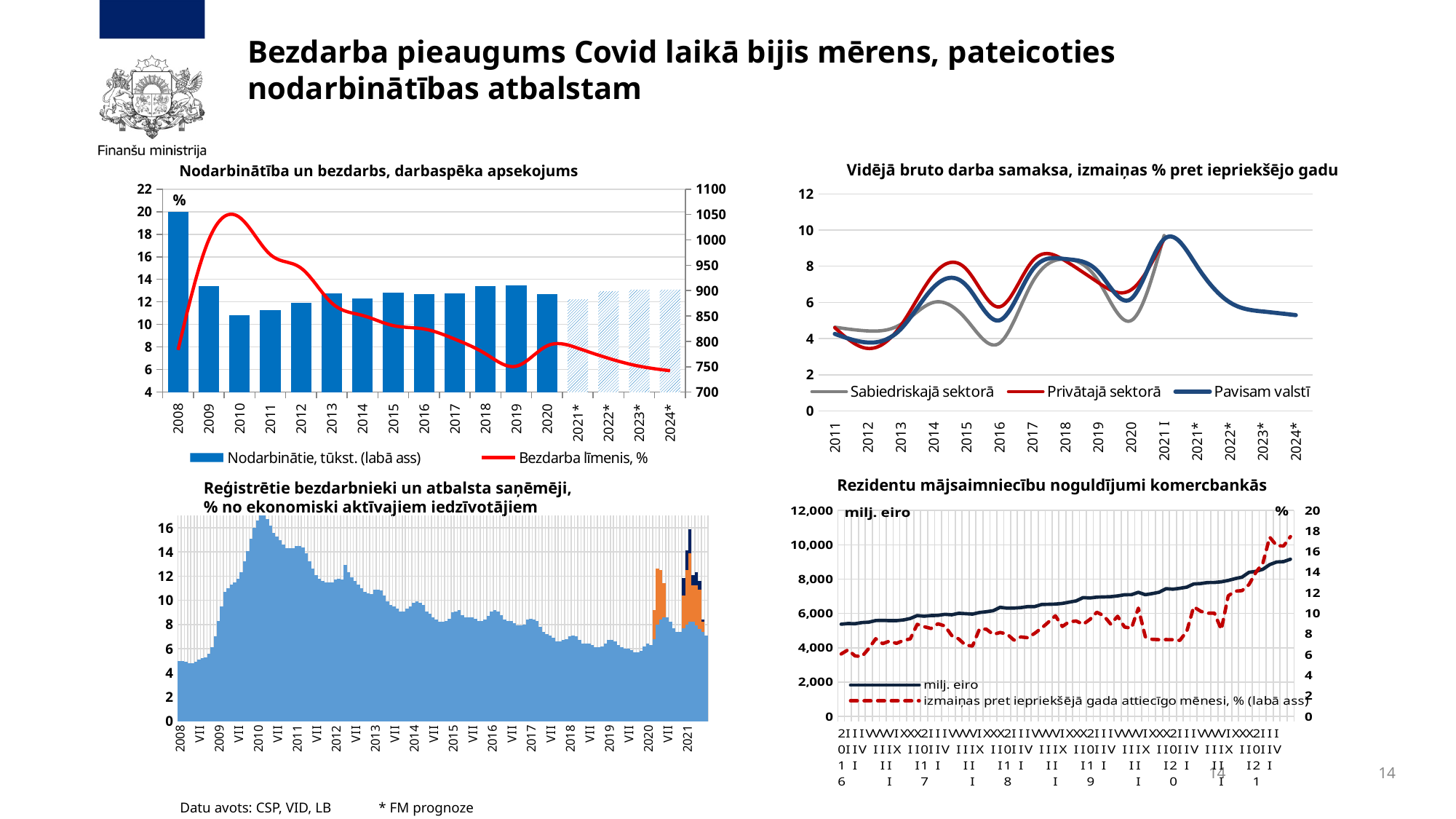
In the chart titled 'Vidējā bruto darba samaksa, izmaiņas % pret iepriekšējo gadu', is the Sabiedriskajā sektorā value for 2016 greater or less than 6? less In the chart titled 'Nodarbinātība un bezdarbs, darbaspēka apsekojums', how many years are shown on the x axis? 17 In the chart titled 'Vidējā bruto darba samaksa, izmaiņas % pret iepriekšējo gadu', is the Pavisam valstī value for 2021 I greater or less than 8? greater In the chart titled 'Nodarbinātība un bezdarbs, darbaspēka apsekojums', which year has the lowest bar for Nodarbinātie, tūkst.? 2010 In the chart titled 'Nodarbinātība un bezdarbs, darbaspēka apsekojums', is the Nodarbinātie, tūkst. value for 2008 greater or less than 1000? greater In the chart titled 'Rezidentu mājsaimniecību noguldījumi komercbankās', what unit is shown at the top of the left axis? milj. eiro In the chart titled 'Nodarbinātība un bezdarbs, darbaspēka apsekojums', how many series does the legend list? 2 In the chart titled 'Vidējā bruto darba samaksa, izmaiņas % pret iepriekšējo gadu', how many series does the legend list? 3 In the chart titled 'Nodarbinātība un bezdarbs, darbaspēka apsekojums', which year has the highest bar for Nodarbinātie, tūkst.? 2008 In the chart titled 'Rezidentu mājsaimniecību noguldījumi komercbankās', how many series does the legend list? 2 What kind of chart is 'Vidējā bruto darba samaksa, izmaiņas % pret iepriekšējo gadu'? line chart